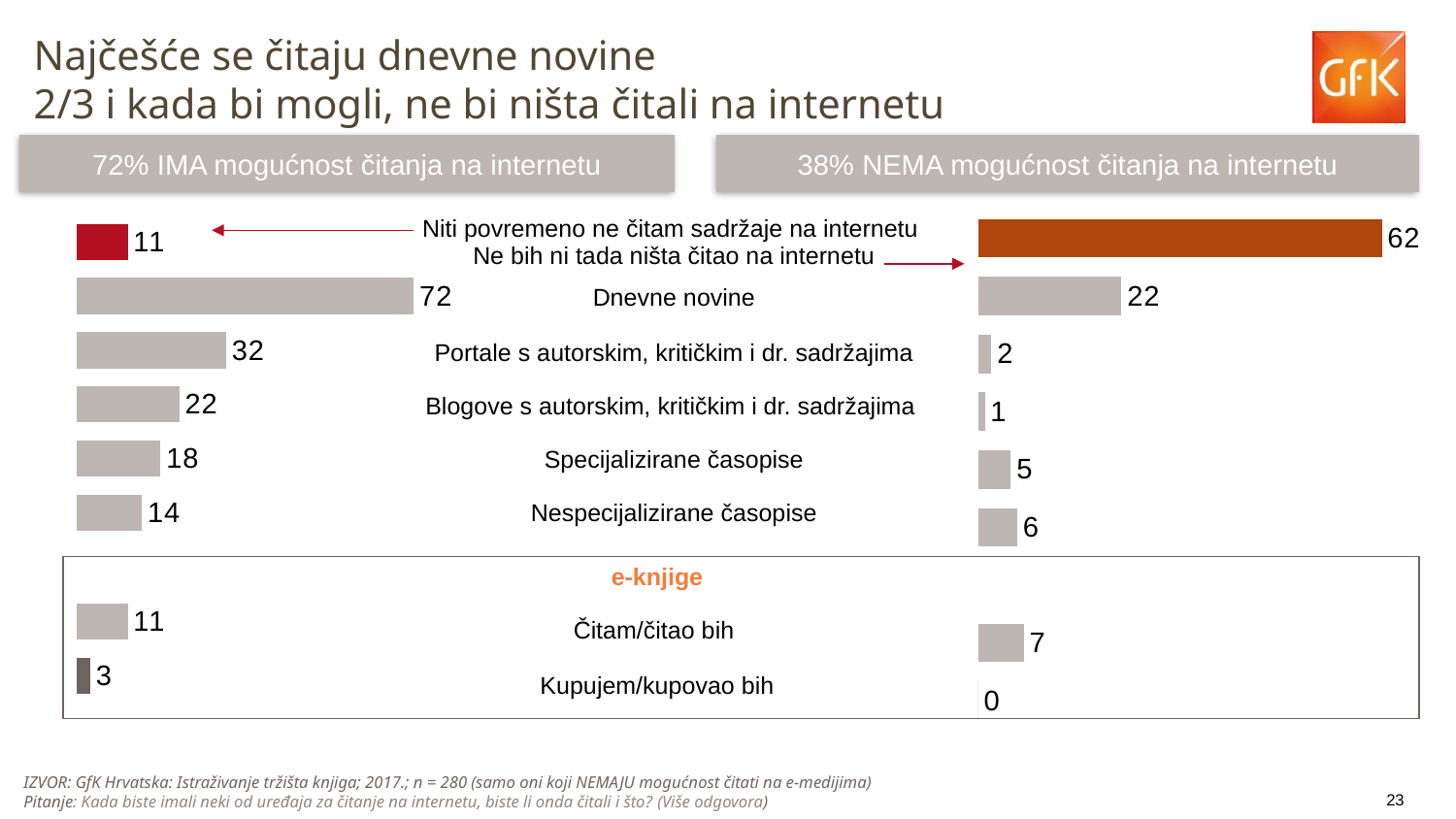
In the left chart (72% IMA mogućnost čitanja na internetu), what is the value for 'Portale s autorskim, kritičkim i dr. sadržajima'? 32 In the right chart (38% NEMA mogućnost čitanja na internetu), what is the value for Čitam/čitao bih? 7 In the left chart (72% IMA mogućnost čitanja na internetu), what is the difference between the values for Dnevne novine and 'Portale s autorskim, kritičkim i dr. sadržajima'? 40 In the right chart (38% NEMA mogućnost čitanja na internetu), what is the value for Dnevne novine? 22 In the right chart (38% NEMA mogućnost čitanja na internetu), which is larger: the value for Specijalizirane časopise or Nespecijalizirane časopise? Nespecijalizirane časopise In the left chart (72% IMA mogućnost čitanja na internetu), what is the value for Dnevne novine? 72 In the right chart (38% NEMA mogućnost čitanja na internetu), which category has the lowest value? Kupujem/kupovao bih In the left chart (72% IMA mogućnost čitanja na internetu), what is the difference between the values for Blogove and Specijalizirane časopise? 4 In the left chart (72% IMA mogućnost čitanja na internetu), which category has the highest value? Dnevne novine In the right chart (38% NEMA mogućnost čitanja na internetu), what is the value for 'Ne bih ni tada ništa čitao na internetu'? 62 In the left chart (72% IMA mogućnost čitanja na internetu), what is the value for Kupujem/kupovao bih? 3 What kind of chart is used on this slide? Bar chart